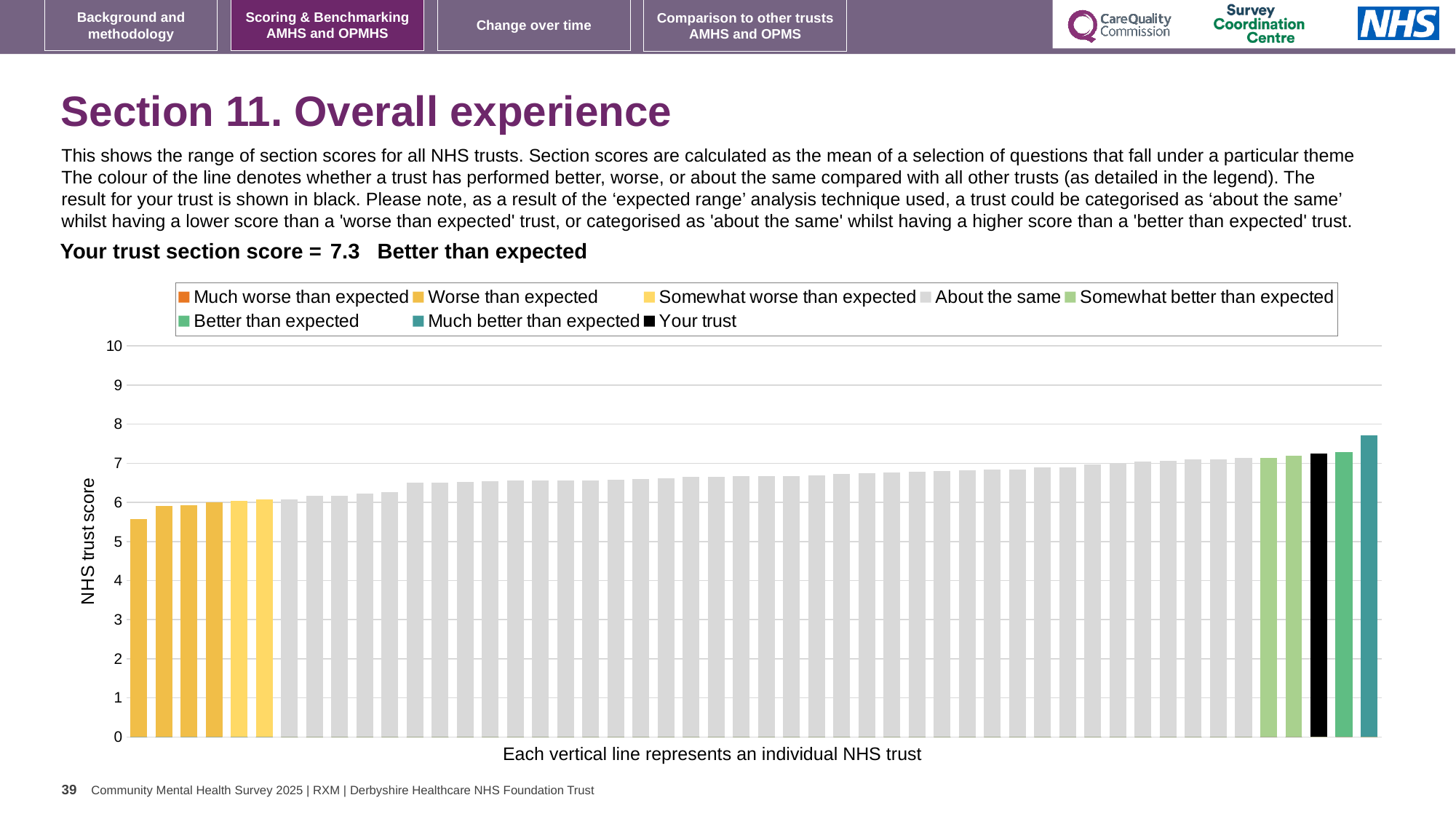
Which category does your trust's section score fall into according to the slide? Better than expected What kind of chart is shown on the slide? bar chart What colour is the bar representing your trust? black How many entries does the chart legend list? 8 Is the value for your trust (the black bar) greater or less than 7? greater What is the label on the vertical axis of the chart? NHS trust score Is your trust's bar higher or lower than the rightmost bar? lower What is the section score for your trust shown on the slide? 7.3 Is the value of the rightmost bar greater or less than 7? greater Is the value for your trust (the black bar) greater or less than 8? less Do the bar values rise or fall from left to right along the x axis? rise